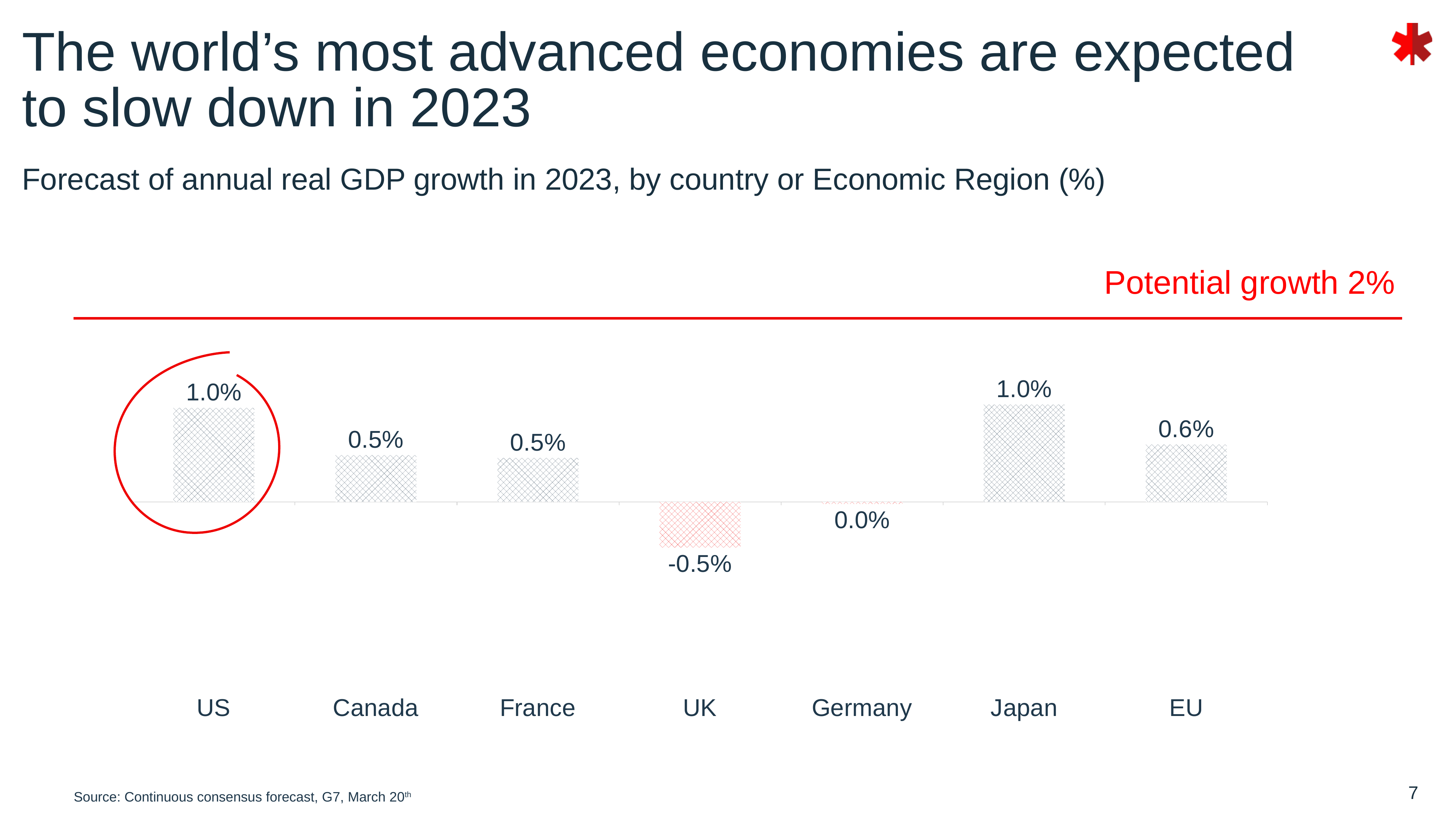
What is the forecast GDP growth for the EU? 0.6% What is the forecast GDP growth for Germany? 0.0% What is the difference between the forecast GDP growth for Japan and Canada? 0.5% What potential growth rate is marked by the red line on the chart? 2% How many countries or regions are shown in the chart? 7 Which country's bar is circled in red on the chart? US What kind of chart is shown on the slide? Bar chart Which country or region has the lowest forecast GDP growth? UK What is the forecast GDP growth for the US? 1.0% What is the difference between the forecast GDP growth for the EU and the UK? 1.1% What is the forecast GDP growth for the UK? -0.5% Which has the higher forecast GDP growth, the EU or France? EU